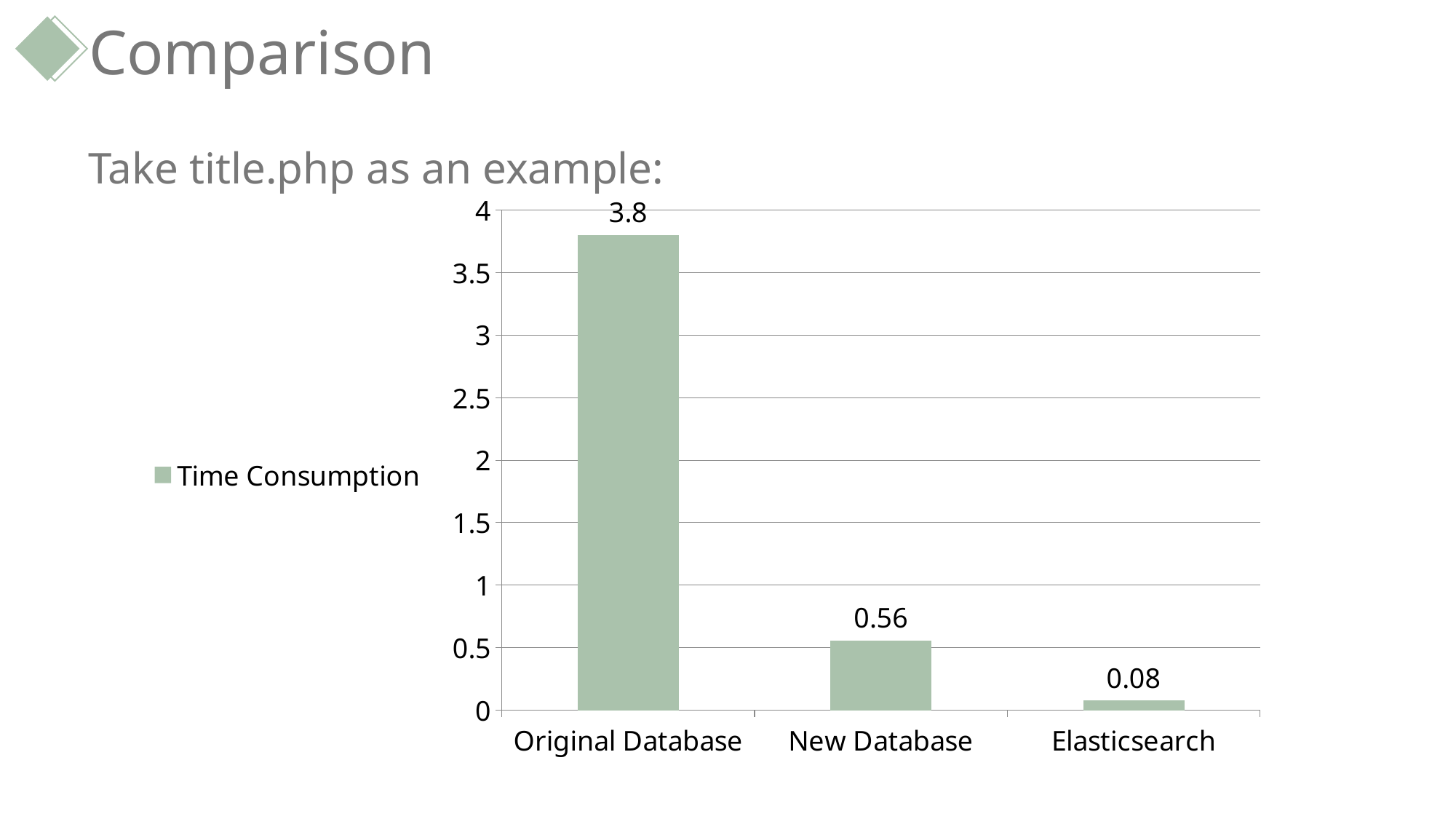
Which category has the lowest Time Consumption? Elasticsearch How many series does the chart legend list? 1 What is the difference in Time Consumption between Original Database and New Database? 3.24 Which category has the highest Time Consumption? Original Database What is the Time Consumption value for Original Database? 3.8 Which has a larger Time Consumption, New Database or Elasticsearch? New Database Is the Time Consumption for Original Database greater or less than 3.5? greater What is the difference in Time Consumption between New Database and Elasticsearch? 0.48 What is the Time Consumption value for Elasticsearch? 0.08 What kind of chart is shown on the slide? bar chart What is the Time Consumption value for New Database? 0.56 How many categories are shown on the x axis of the chart? 3